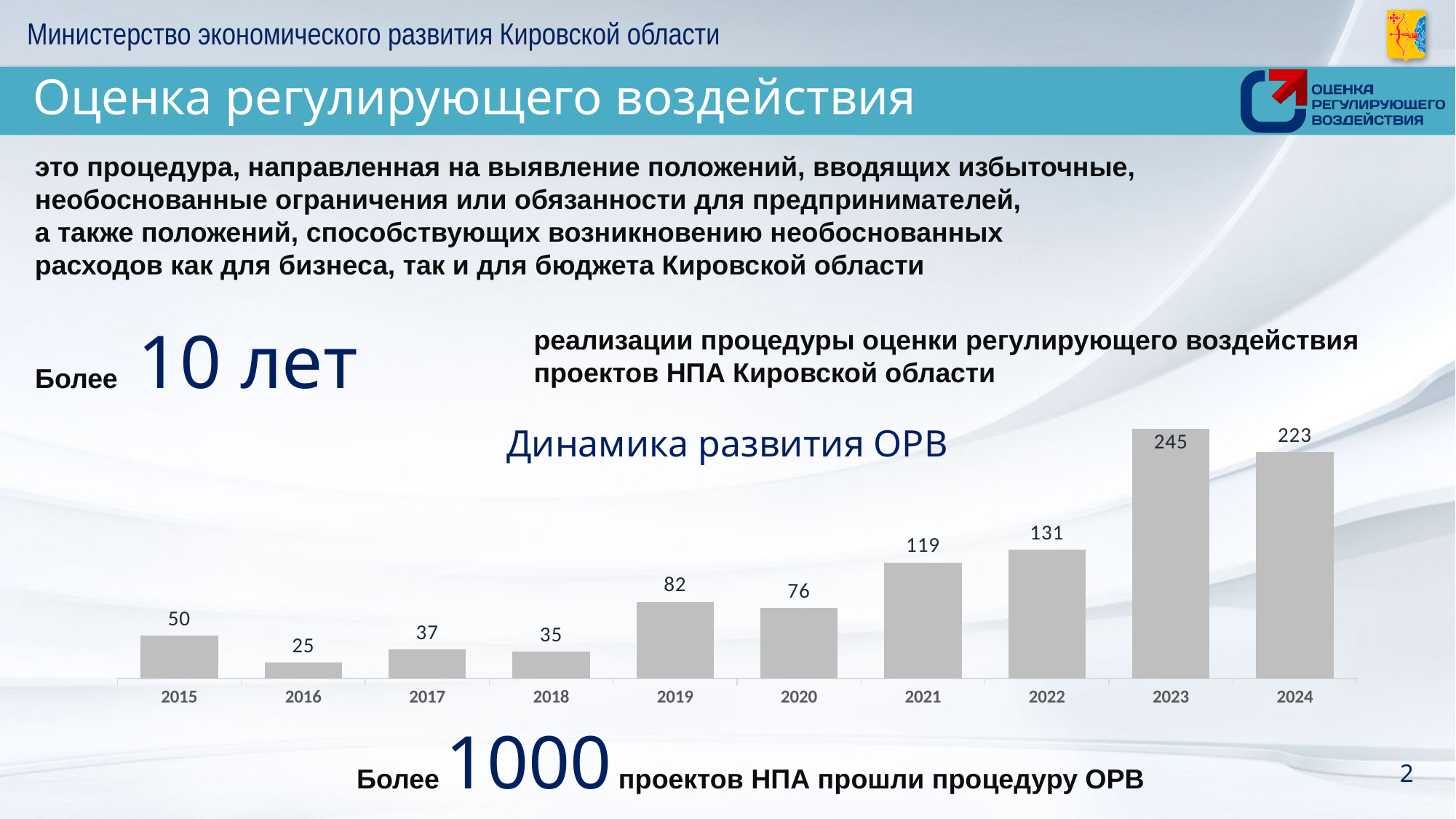
Which is larger, the value for 2019 or the value for 2020? 2019 How many years are shown in the chart? 10 Which is larger, the value for 2015 or the value for 2017? 2015 What is the value for 2019 in the chart? 82 What is the difference between the values for 2022 and 2021? 12 What kind of chart is shown on the slide? bar chart What is the difference between the values for 2023 and 2024? 22 Which year has the lowest value in the chart? 2016 What is the title of the chart? Динамика развития ОРВ Which year has the highest value in the chart? 2023 Do the values generally rise or fall from 2018 to 2023? rise What is the value for 2024 in the chart? 223